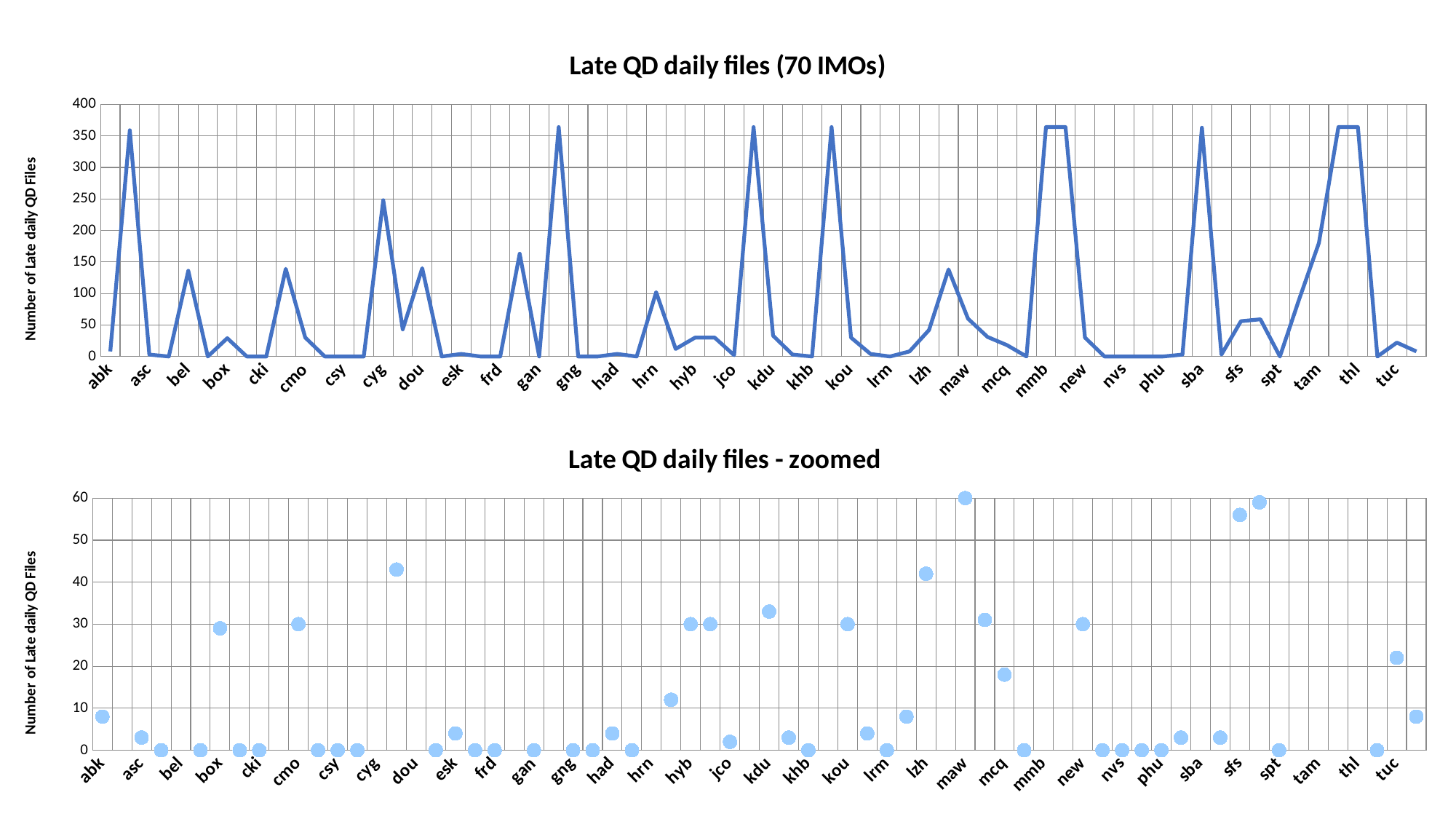
In the bottom chart, 'Late QD daily files - zoomed', is the value for lzh greater or less than 30? greater What is the y-axis label of the bottom chart, 'Late QD daily files - zoomed'? Number of Late daily QD Files In the top chart, 'Late QD daily files (70 IMOs)', is the value for asc greater or less than 300? less What kind of chart is the bottom chart, 'Late QD daily files - zoomed'? scatter chart In the bottom chart, 'Late QD daily files - zoomed', is the value for maw greater or less than 50? greater What kind of chart is the top chart, 'Late QD daily files (70 IMOs)'? line chart In the top chart, 'Late QD daily files (70 IMOs)', which has the higher value, bel or box? bel What is the title of the top chart? Late QD daily files (70 IMOs) In the bottom chart, 'Late QD daily files - zoomed', which has the higher value, tuc or lrm? tuc In the top chart, 'Late QD daily files (70 IMOs)', which has the higher value, cyg or cmo? cyg